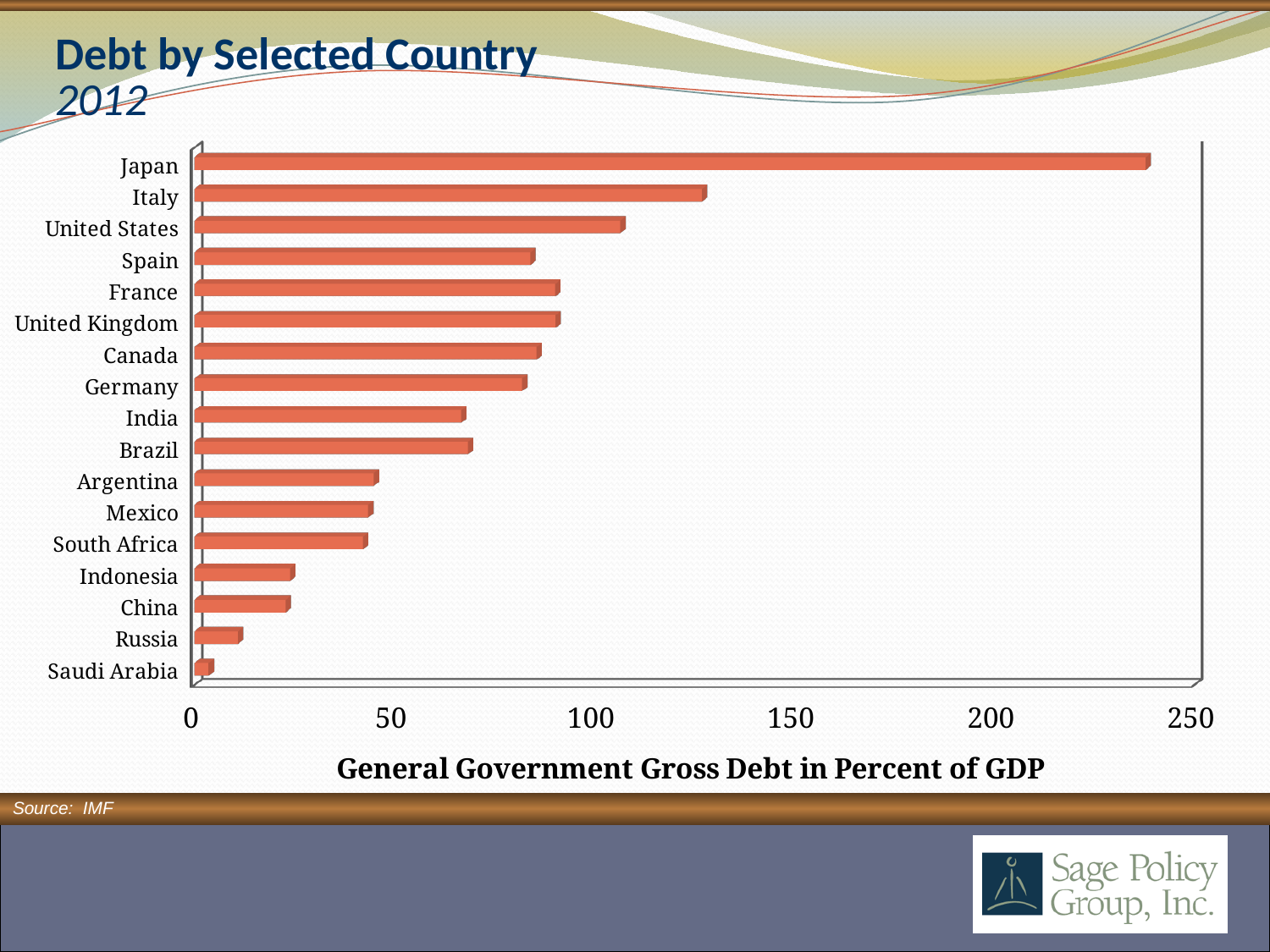
Is the value for Japan greater or less than 200? greater How many countries are shown in the chart? 17 Is the value for Russia greater or less than 50? less Is the value for Italy greater or less than 100? greater What kind of chart is shown on the slide? bar chart What is the label on the horizontal axis of the chart? General Government Gross Debt in Percent of GDP Which has a higher debt in percent of GDP, Italy or the United States? Italy Which has a higher debt in percent of GDP, Argentina or Indonesia? Argentina Which country has the lowest general government gross debt in percent of GDP? Saudi Arabia Which country has the highest general government gross debt in percent of GDP? Japan